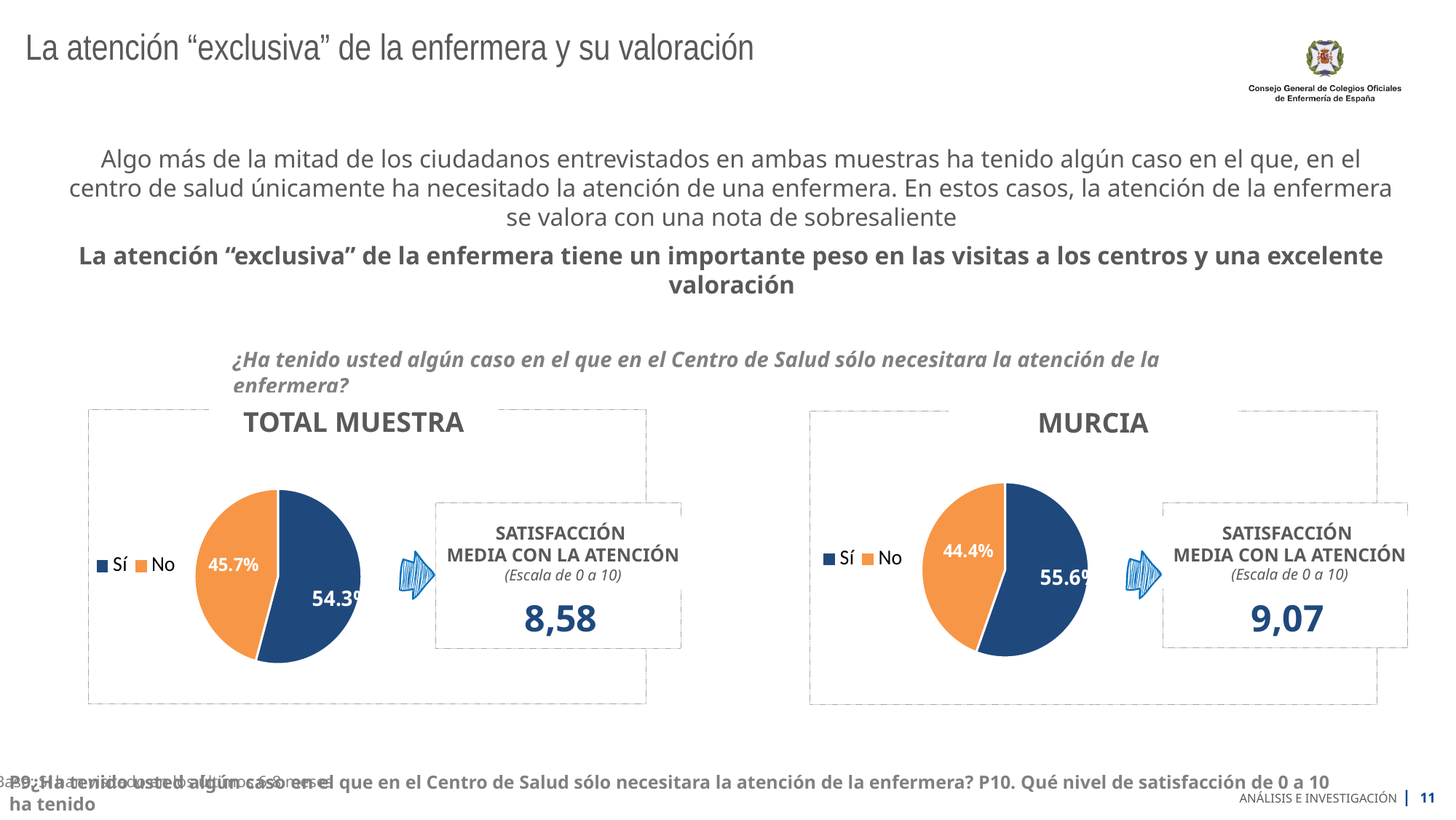
Is the Sí share larger in the TOTAL MUESTRA chart or in the MURCIA chart? MURCIA In the TOTAL MUESTRA pie chart, what percentage answered No? 45.7% In the TOTAL MUESTRA pie chart, what colour is the Sí slice? Dark blue In the MURCIA pie chart, what is the difference between the Sí and No percentages? 11.2% In the TOTAL MUESTRA pie chart, which slice is the largest? Sí In the TOTAL MUESTRA pie chart, what is the difference between the Sí and No percentages? 8.6% In the TOTAL MUESTRA pie chart, what percentage answered Sí? 54.3% In the MURCIA pie chart, what percentage answered Sí? 55.6% How many categories does the legend of the MURCIA pie chart list? 2 What type of chart is used for TOTAL MUESTRA? Pie chart In the MURCIA pie chart, what percentage answered No? 44.4% In the MURCIA pie chart, which slice is the smallest? No